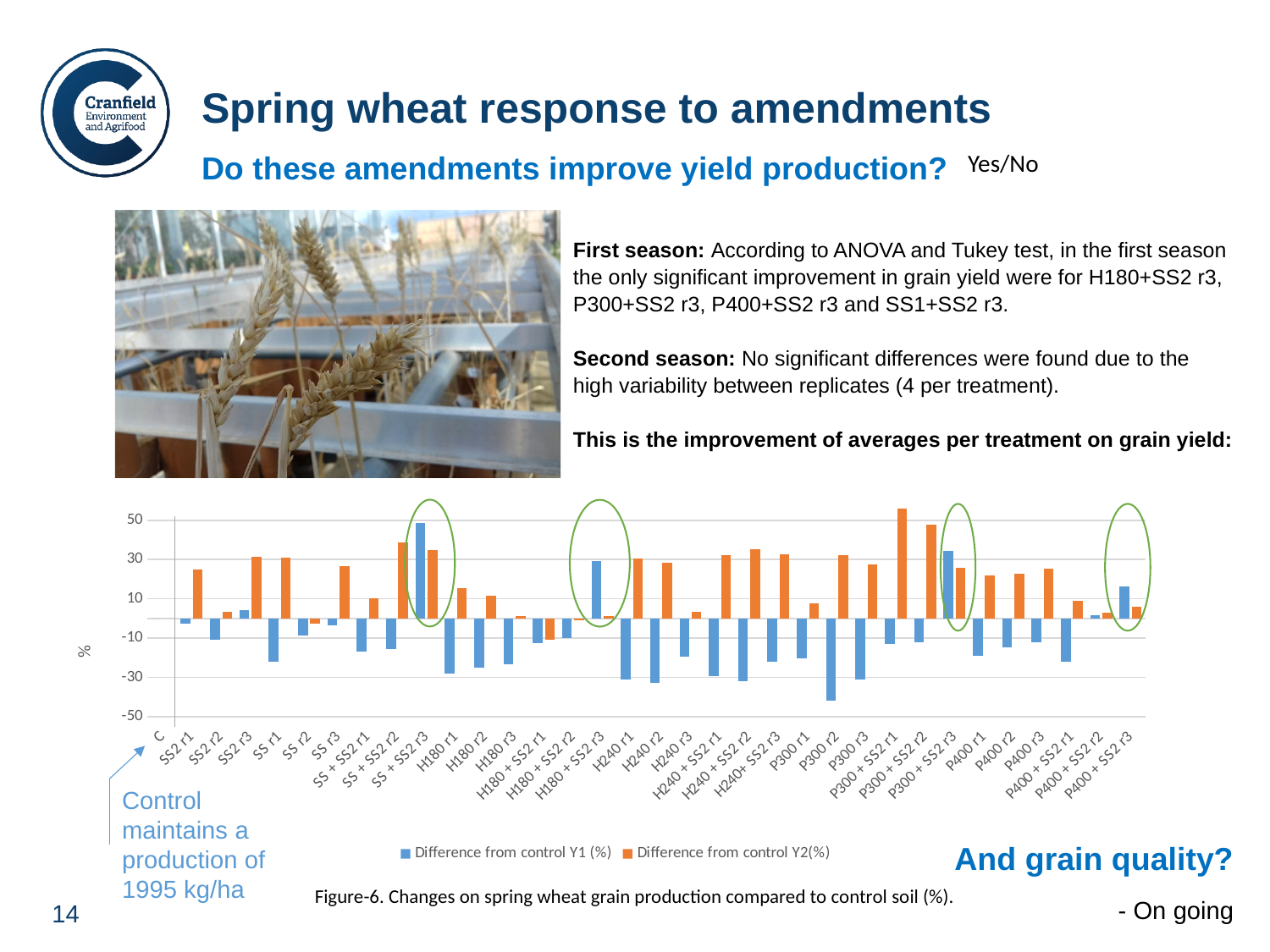
Is the 'Difference from control Y1 (%)' value for P300 r2 greater or less than -30? less Is the 'Difference from control Y1 (%)' value for SS + SS2 r3 greater or less than 30? greater What kind of chart is shown on the slide? bar chart Which category has the highest 'Difference from control Y1 (%)' bar? SS + SS2 r3 Which category has the highest 'Difference from control Y2(%)' bar? P300 + SS2 r1 What is the label on the vertical axis of the chart? % Which has the larger 'Difference from control Y2(%)' value, SS r1 or SS r2? SS r1 Is the 'Difference from control Y2(%)' value for P300 + SS2 r1 greater or less than 50? greater How many treatment categories are shown along the x axis of the chart? 34 How many series does the chart legend list? 2 Which category has the lowest 'Difference from control Y1 (%)' bar? P300 r2 Which colour represents 'Difference from control Y2(%)' in the chart legend? orange